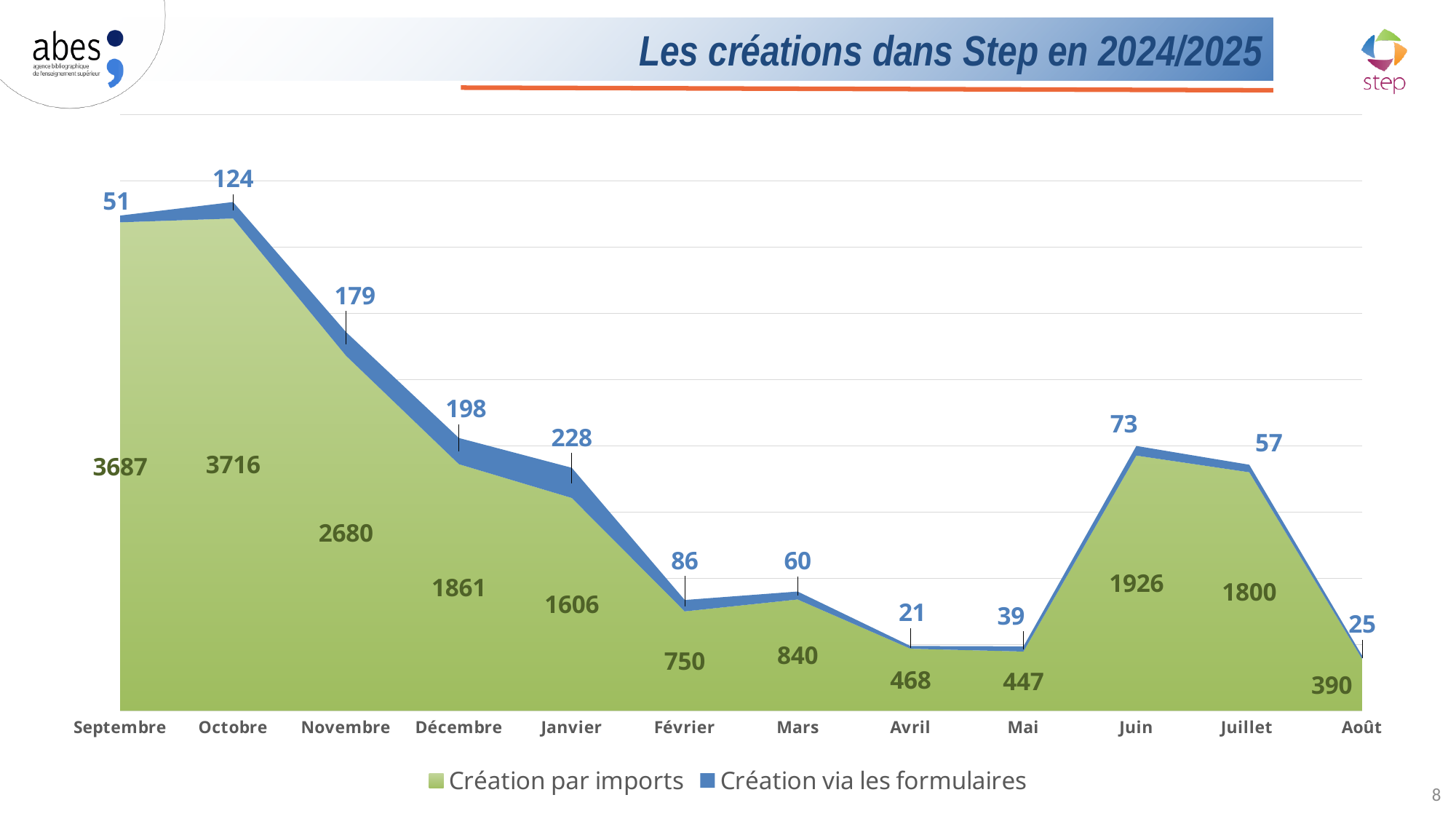
What is the title of the slide? Les créations dans Step en 2024/2025 What is the total of the two series for Septembre? 3738 What is the value of "Création via les formulaires" for Janvier? 228 How many series does the legend list? 2 Which month has the highest value for "Création par imports"? Octobre What kind of chart is shown on the slide? Stacked area chart Which month has the lowest value for "Création via les formulaires"? Avril Which is larger, the "Création via les formulaires" value for Février or for Mars? Février What is the value of "Création par imports" for Novembre? 2680 How many months are shown on the x axis? 12 What is the value of "Création par imports" for Août? 390 What is the difference between the "Création par imports" values for Juin and Juillet? 126